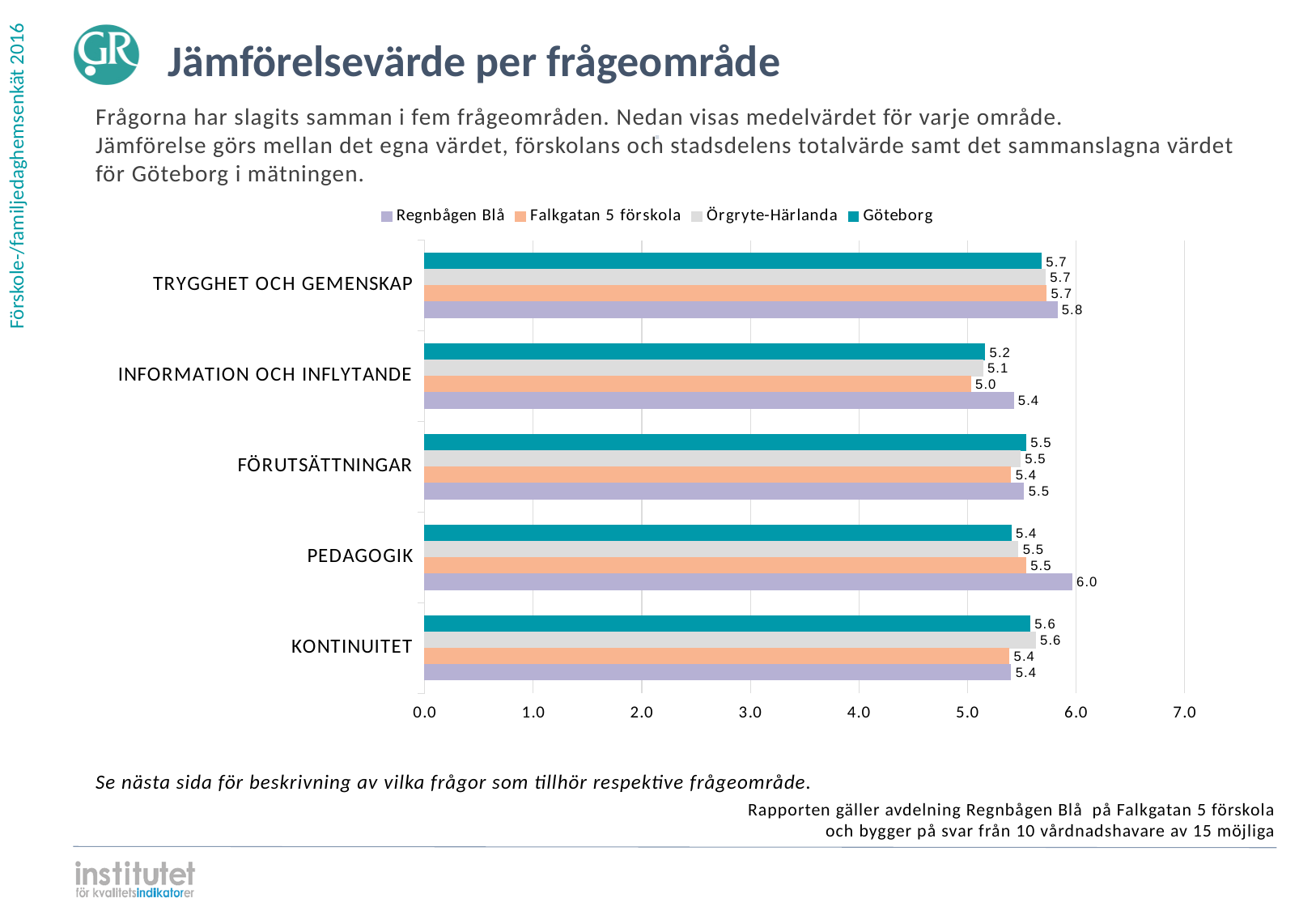
What kind of chart is shown on the slide? Bar chart What is the maximum value shown on the x axis of the chart? 7.0 What is the value for Göteborg in the KONTINUITET category? 5.6 In the INFORMATION OCH INFLYTANDE category, which is larger: the value for Regnbågen Blå or the value for Falkgatan 5 förskola? Regnbågen Blå What is the difference between the Regnbågen Blå value and the Göteborg value in the PEDAGOGIK category? 0.6 In which category does Regnbågen Blå have its highest value? PEDAGOGIK How many categories (frågeområden) are shown on the chart? 5 What is the value for Örgryte-Härlanda in the TRYGGHET OCH GEMENSKAP category? 5.7 What is the value for Falkgatan 5 förskola in the INFORMATION OCH INFLYTANDE category? 5.0 In which category does Falkgatan 5 förskola have its lowest value? INFORMATION OCH INFLYTANDE What is the value for Regnbågen Blå in the PEDAGOGIK category? 6.0 How many series does the legend list? 4